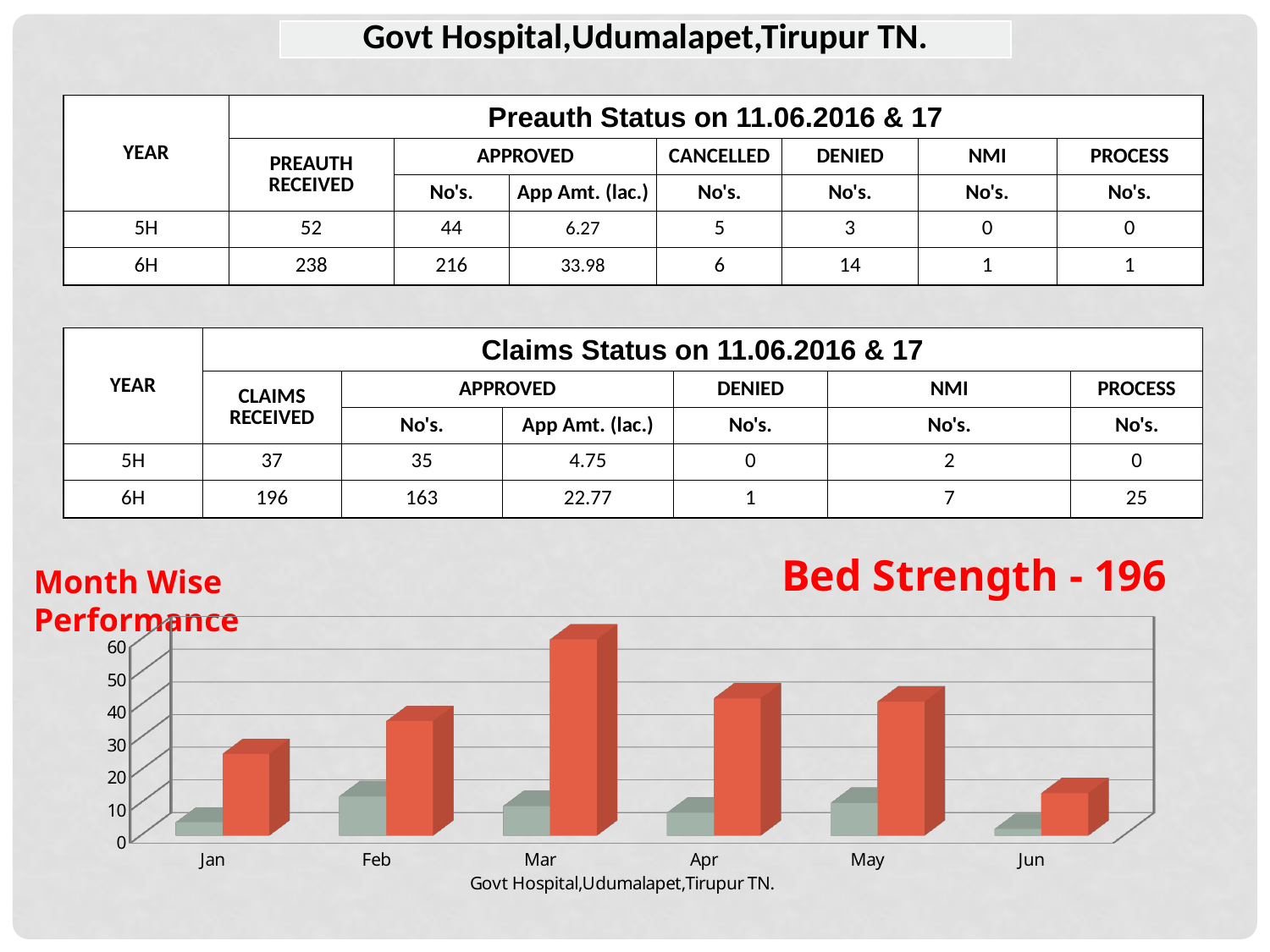
In the Month Wise Performance chart, is the red bar for Apr greater or less than 30? greater How many months are shown on the x axis of the Month Wise Performance chart? 6 In the Month Wise Performance chart, do the red bars rise or fall from Jan to Mar? rise What kind of chart is shown at the bottom of the slide? bar chart In the Month Wise Performance chart, is the red bar for Mar or the red bar for Jun larger? Mar What is the highest value labelled on the vertical axis of the Month Wise Performance chart? 60 In the Month Wise Performance chart, is the red bar for Mar greater or less than 50? greater In the Month Wise Performance chart, is the red bar for Jan greater or less than 40? less In the Month Wise Performance chart, which month has the tallest red bar? Mar What text appears below the x axis of the Month Wise Performance chart? Govt Hospital,Udumalapet,Tirupur TN. In the Month Wise Performance chart, which month has the shortest red bar? Jun